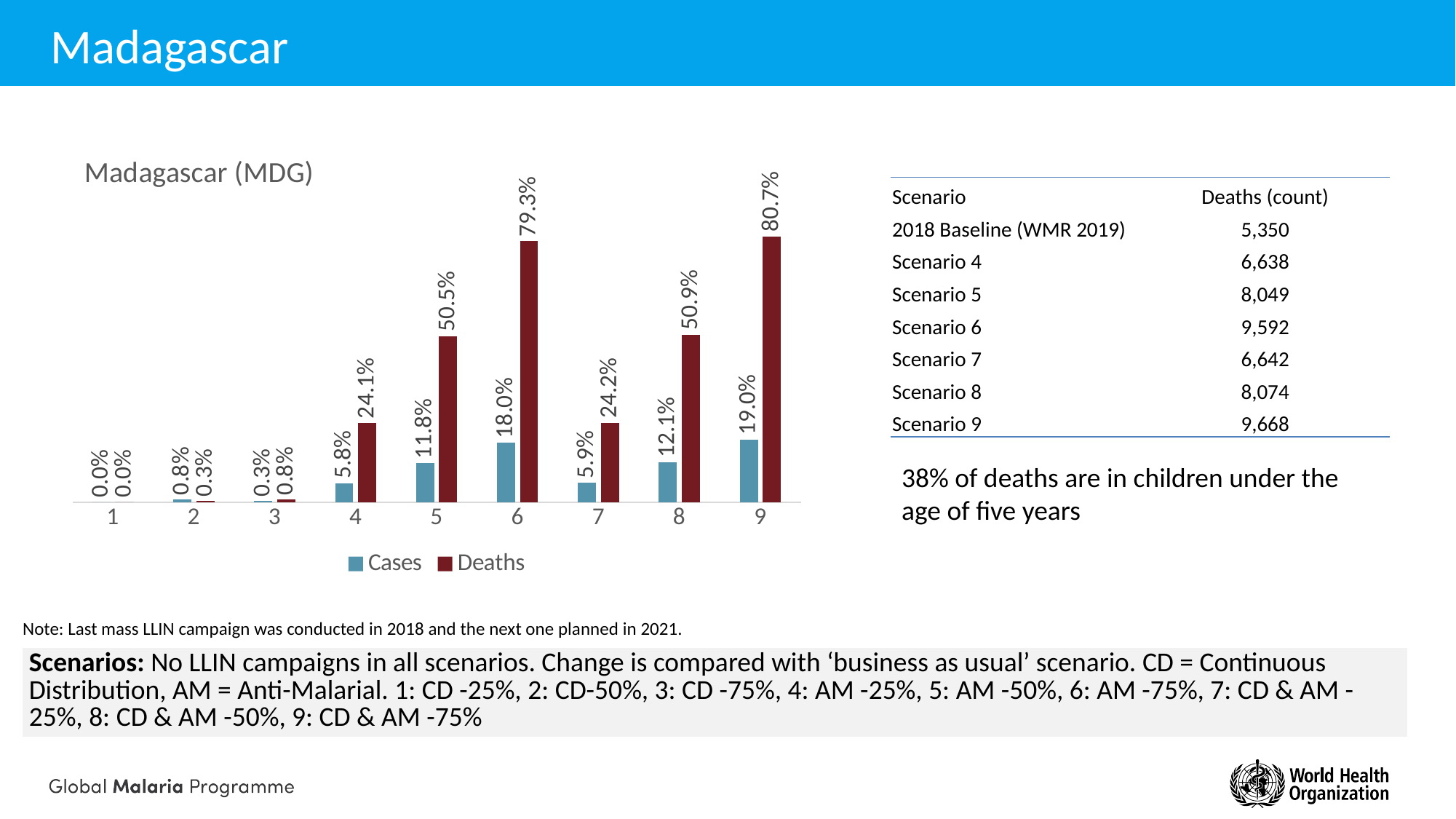
How many series does the chart legend list? 2 What kind of chart is shown on the slide? Bar chart What is the difference between the Deaths and Cases values for scenario 5? 38.7% Which is larger, the Cases value for scenario 5 or the Cases value for scenario 8? Scenario 8 What is the Cases value for scenario 4? 5.8% What is the title of the chart? Madagascar (MDG) What is the difference between the Deaths values for scenario 9 and scenario 6? 1.4% What is the Deaths value for scenario 6? 79.3% Which scenario has the lowest Cases value? 1 Which scenario has the highest Deaths value? 9 What is the Cases value for scenario 9? 19.0% How many scenarios are shown on the x axis of the chart? 9